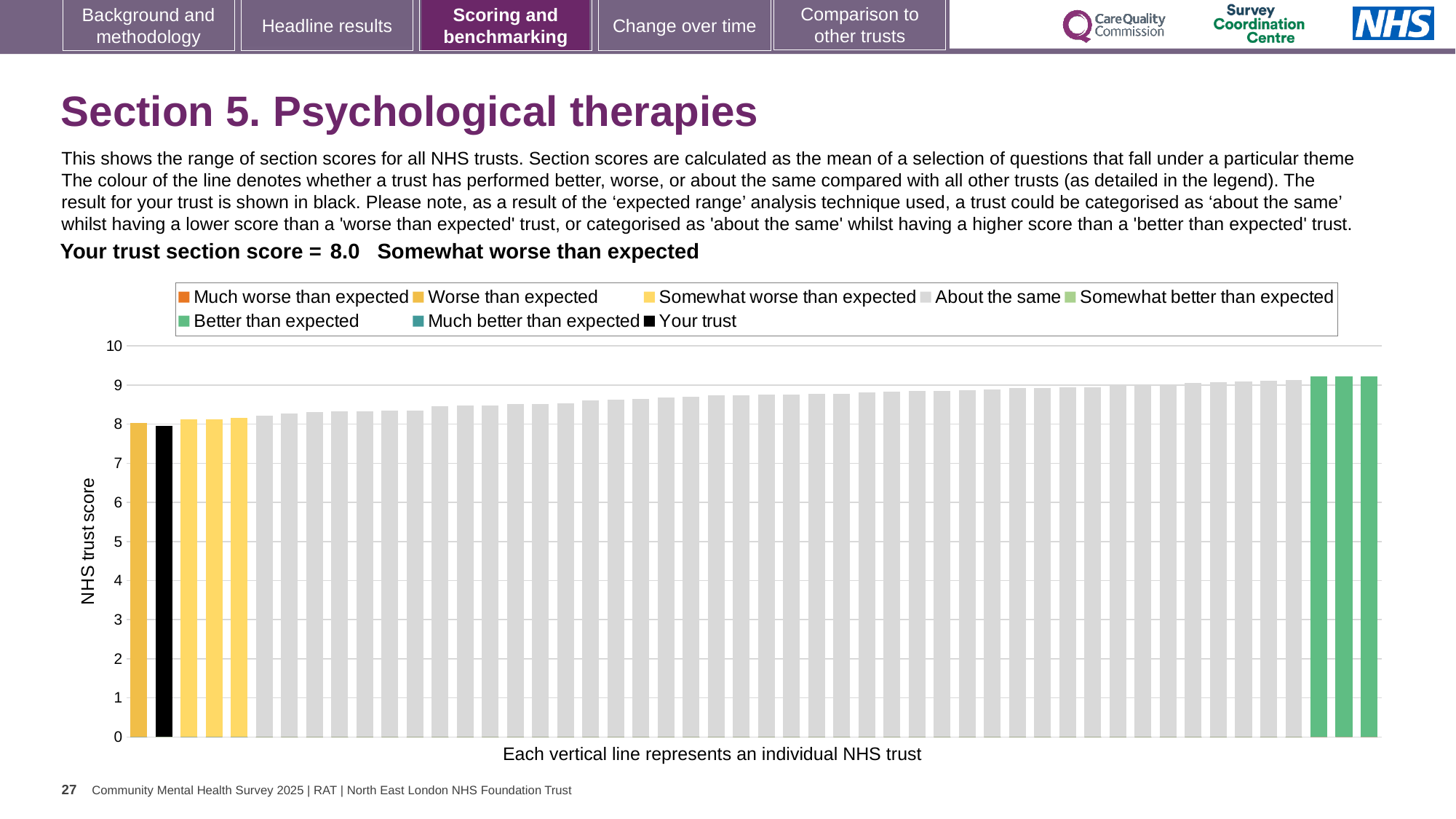
How many entries does the chart legend list? 8 What is the title of the vertical axis? NHS trust score Do the bar values rise or fall from left to right along the x axis? rise How many green bars are shown at the right end of the chart? 3 Is the value for your trust greater or less than 9? less Which category is your trust's section score placed in? Somewhat worse than expected What kind of chart is shown on the slide? bar chart How many light yellow (Somewhat worse than expected) bars are shown in the chart? 3 What colour is the bar representing your trust? black Is the value for your trust greater or less than 5? greater What is the section score for your trust shown on the slide? 8.0